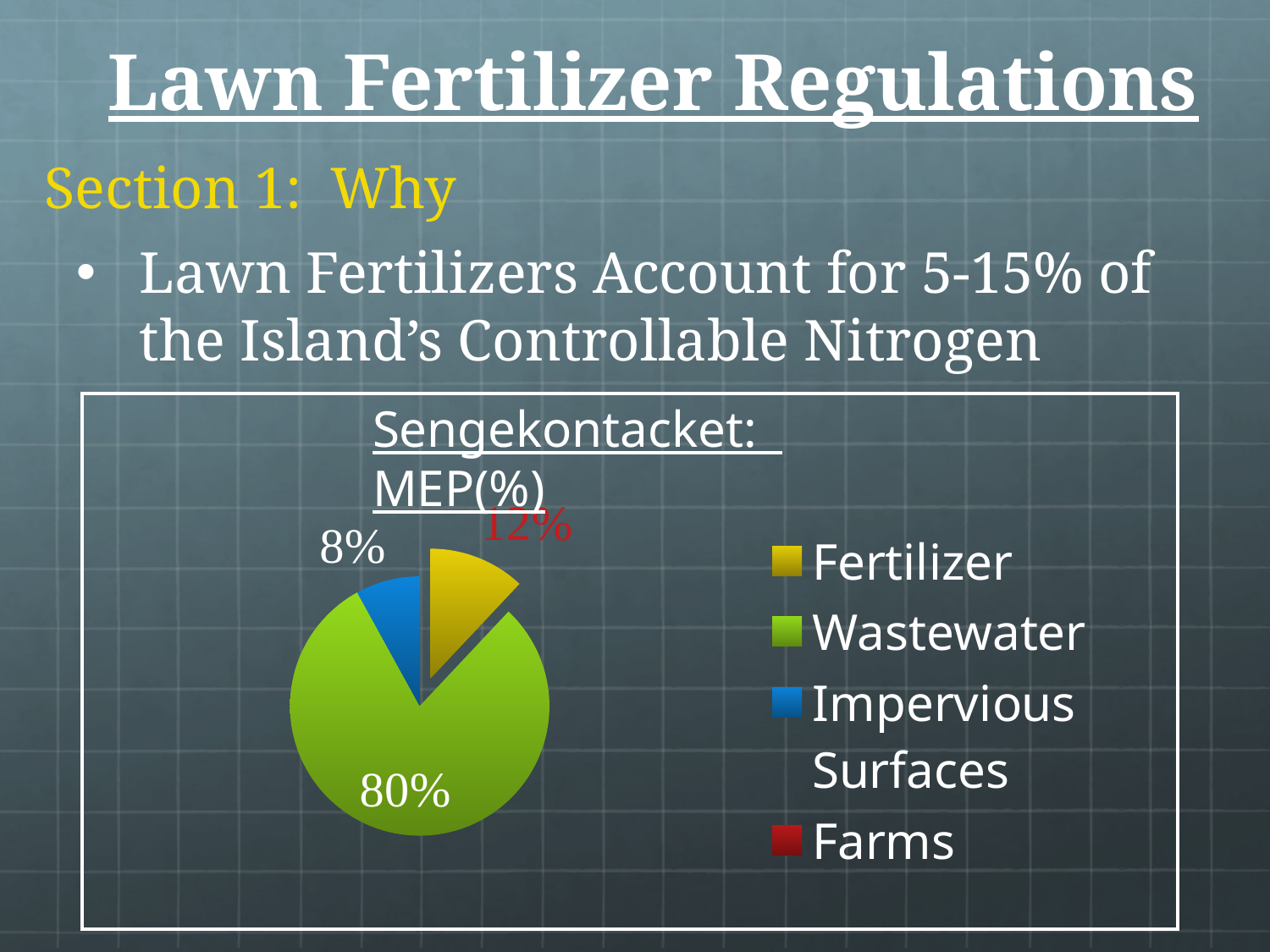
What colour represents Wastewater in the pie chart? green What kind of chart is shown on the slide? pie chart What percentage does the Wastewater slice represent in the Sengekontacket: MEP(%) pie chart? 80% What is the difference in percentage points between the Wastewater slice and the Fertilizer slice? 68% What percentage does the Fertilizer slice represent in the pie chart? 12% What percentage does the Impervious Surfaces slice represent in the pie chart? 8% Which category has the largest share of the pie chart? Wastewater What is the difference in percentage points between the Fertilizer slice and the Impervious Surfaces slice? 4% How many categories does the legend of the pie chart list? 4 Which is larger in the pie chart, Fertilizer or Impervious Surfaces? Fertilizer What is the title of the pie chart? Sengekontacket: MEP(%) How many slices in the pie chart have a percentage label printed? 3